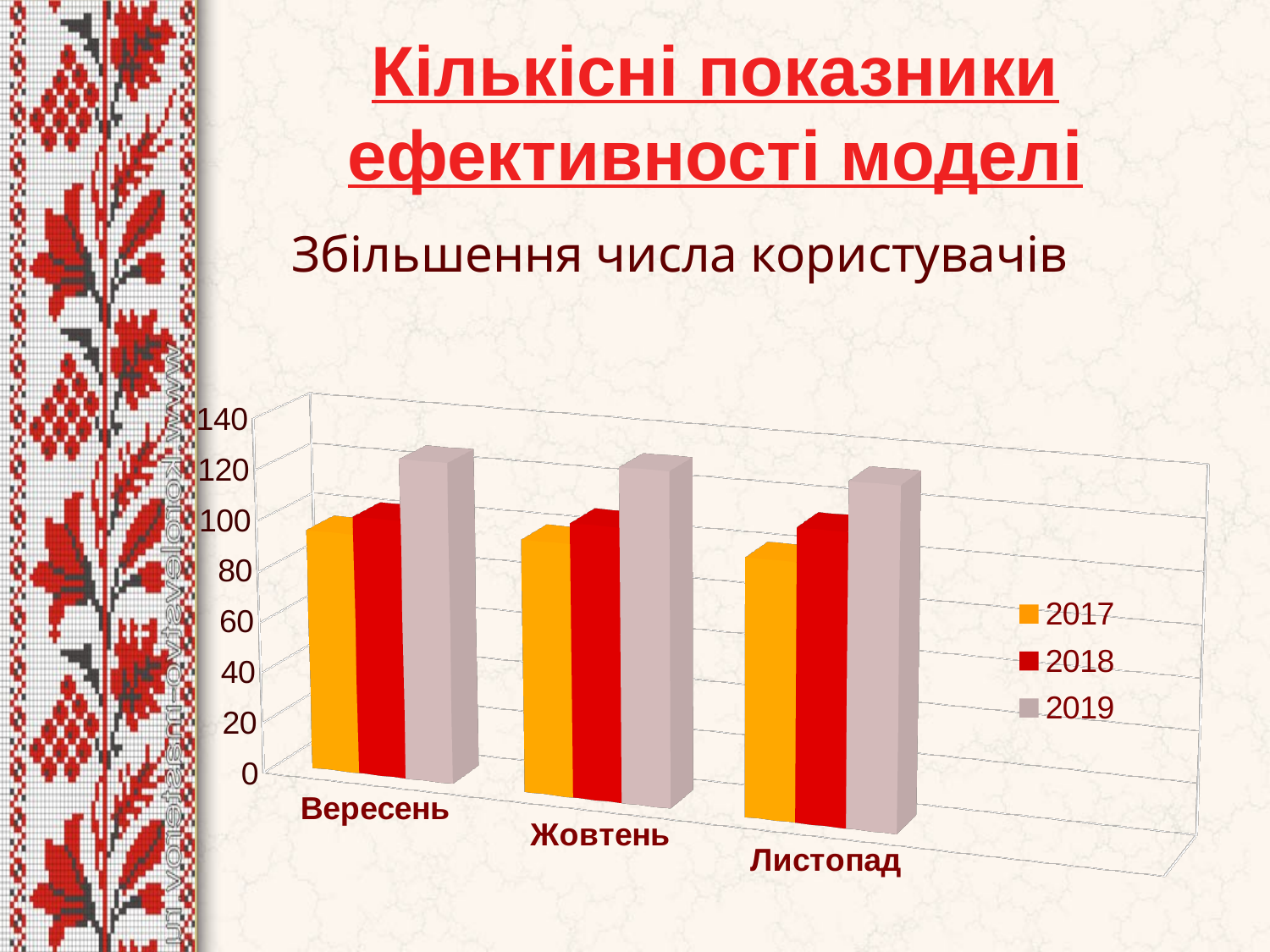
Is the value for 2017 in Вересень greater or less than 120? less Is the value for 2019 in Вересень greater or less than 100? greater Is the value for 2018 in Листопад greater or less than 120? less How many categories (months) are shown on the x axis of the chart? 3 Which series are listed in the chart legend? 2017, 2018, 2019 What is the subtitle shown above the chart? Збільшення числа користувачів What kind of chart is shown on the slide? bar chart In Вересень, which series has the larger value: 2017 or 2019? 2019 How many series does the chart legend list? 3